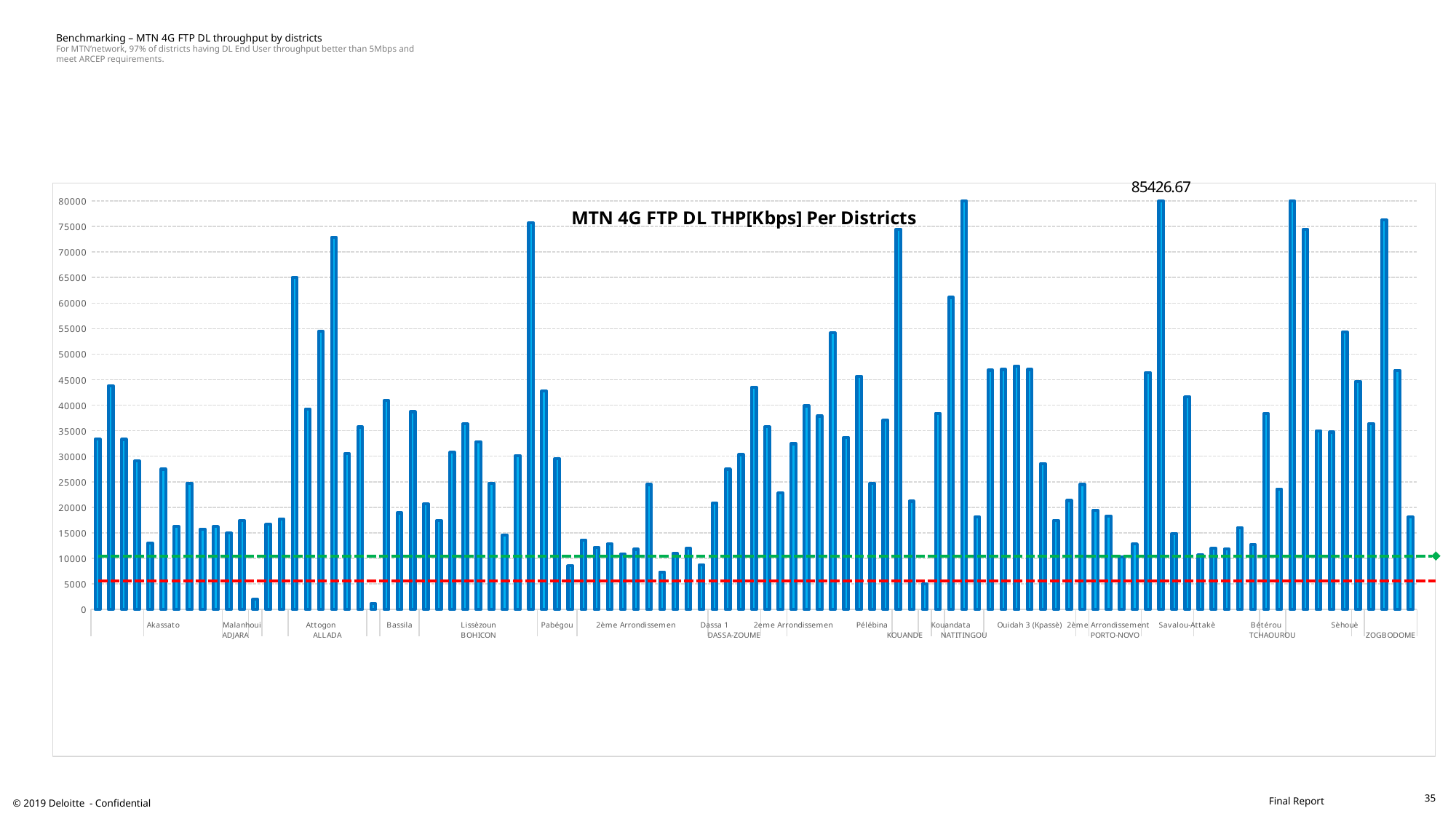
What kind of chart is shown on the slide? bar chart What is the title of the chart? MTN 4G FTP DL THP[Kbps] Per Districts What is the only data label value printed on the chart? 85426.67 What is the highest tick value shown on the vertical axis? 80000 Is the bar labelled 85426.67 greater or less than 80000? greater